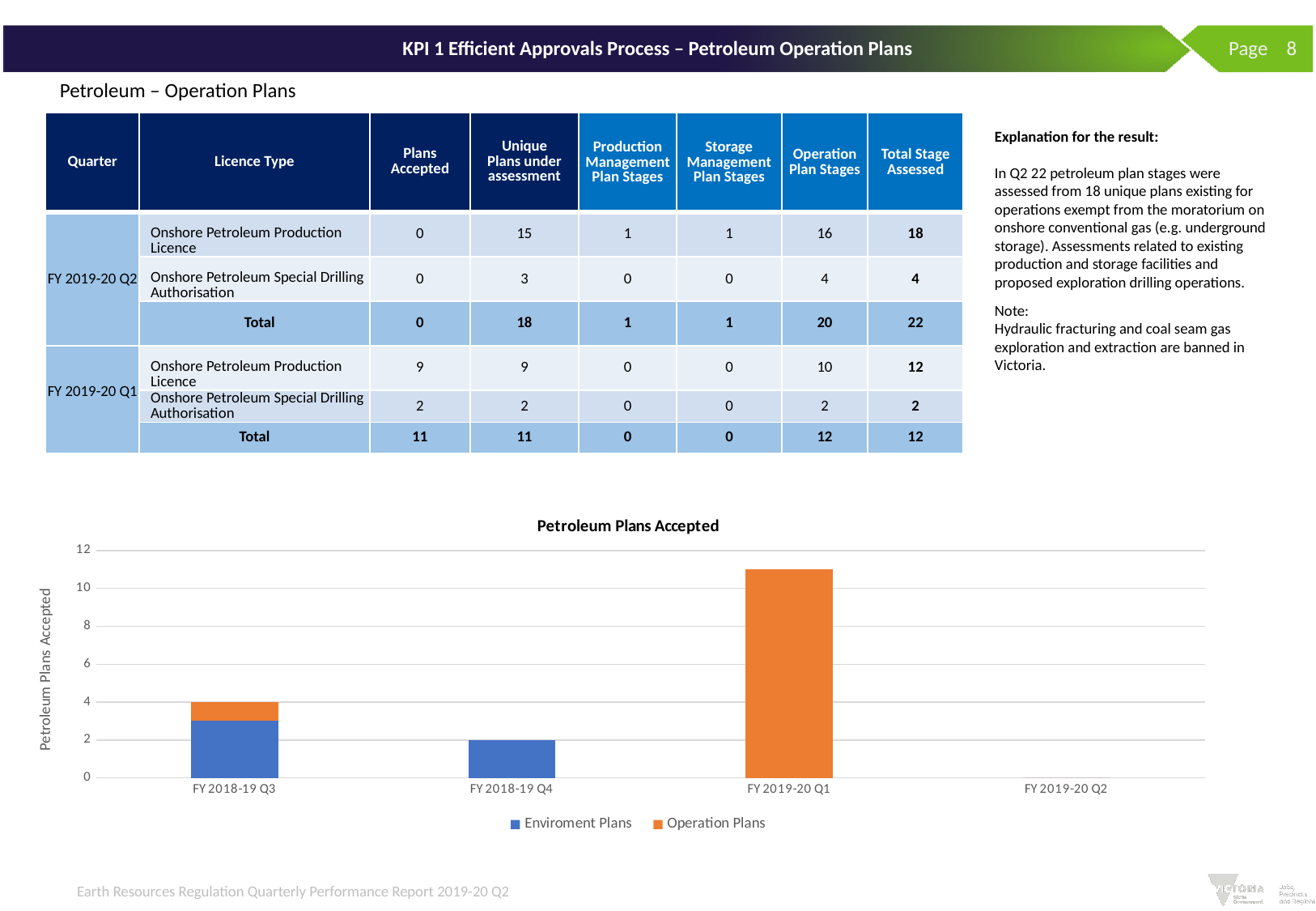
In the "Petroleum Plans Accepted" chart, is the bar for FY 2019-20 Q1 greater or less than 10? greater What are the two legend entries in the "Petroleum Plans Accepted" chart? Enviroment Plans, Operation Plans In the "Petroleum Plans Accepted" chart, what is the total height of the stacked bar for FY 2018-19 Q3? 4 Which quarter has the tallest bar in the "Petroleum Plans Accepted" chart? FY 2019-20 Q1 What is the title of the chart on the slide? Petroleum Plans Accepted How many quarters are shown on the x axis of the "Petroleum Plans Accepted" chart? 4 What kind of chart is the "Petroleum Plans Accepted" chart? bar chart Which quarter shows no bar at all in the "Petroleum Plans Accepted" chart? FY 2019-20 Q2 In the "Petroleum Plans Accepted" chart, is the Enviroment Plans segment for FY 2018-19 Q3 greater or less than 2? greater In the "Petroleum Plans Accepted" chart, what is the Enviroment Plans value for FY 2018-19 Q4? 2 How many series does the legend of the "Petroleum Plans Accepted" chart list? 2 In the "Petroleum Plans Accepted" chart, which bar is taller: FY 2018-19 Q3 or FY 2018-19 Q4? FY 2018-19 Q3